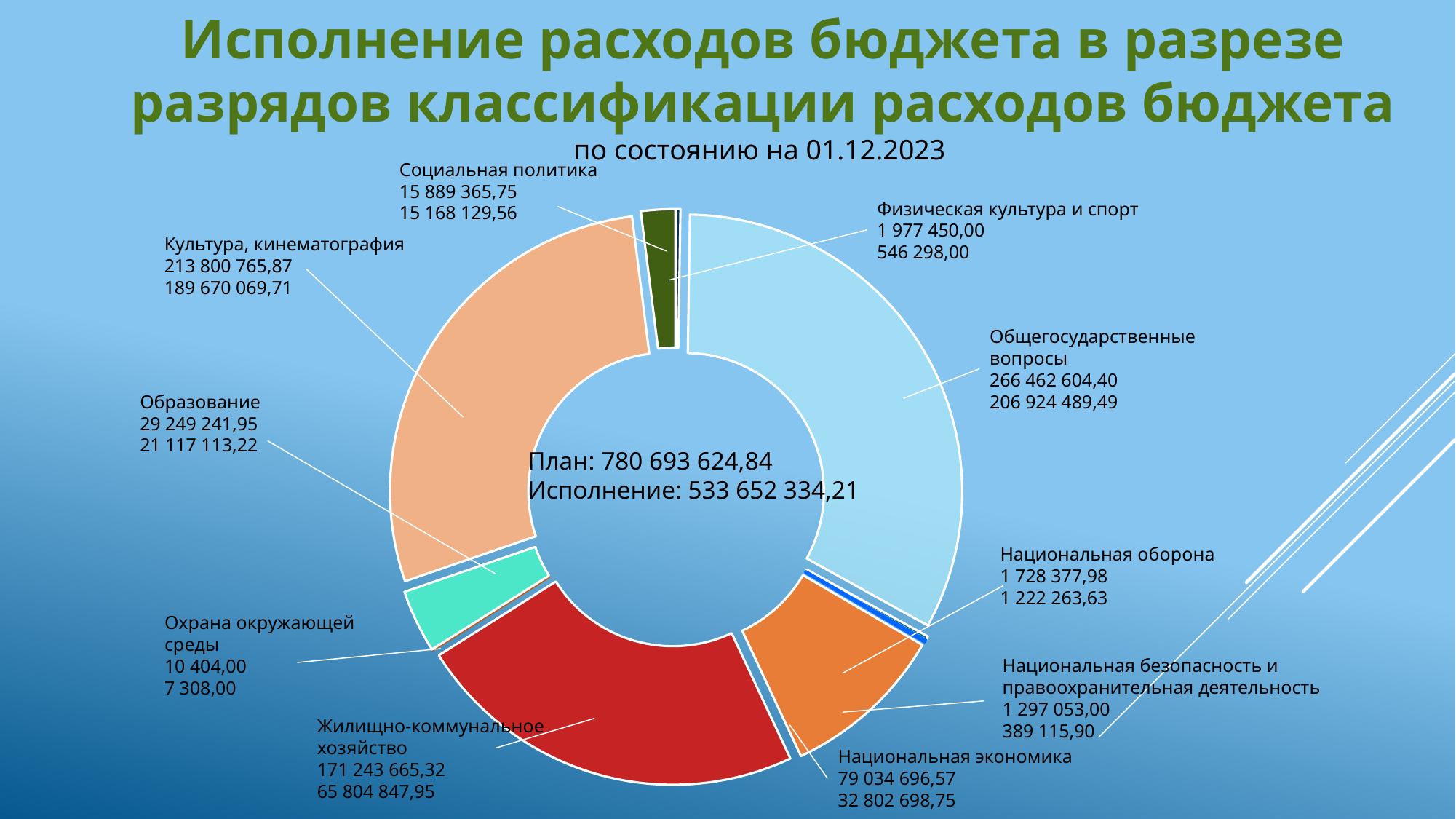
What is the second (execution) value shown for Физическая культура и спорт? 546 298,00 What is the execution value shown for Жилищно-коммунальное хозяйство? 65 804 847,95 What total plan value (План) is shown in the centre of the chart? 780 693 624,84 What is the plan value shown for Национальная экономика? 79 034 696,57 Which has the larger plan value: Культура, кинематография or Жилищно-коммунальное хозяйство? Культура, кинематография Which category has the smallest plan value? Охрана окружающей среды What total execution value (Исполнение) is shown in the centre of the chart? 533 652 334,21 What kind of chart is shown on the slide? Doughnut (pie) chart How many categories (slices) does the chart show? 10 What is the first (plan) value shown for Социальная политика? 15 889 365,75 What is the difference between the plan and execution values for Общегосударственные вопросы? 59 538 114,91 Which category has the largest plan value? Общегосударственные вопросы